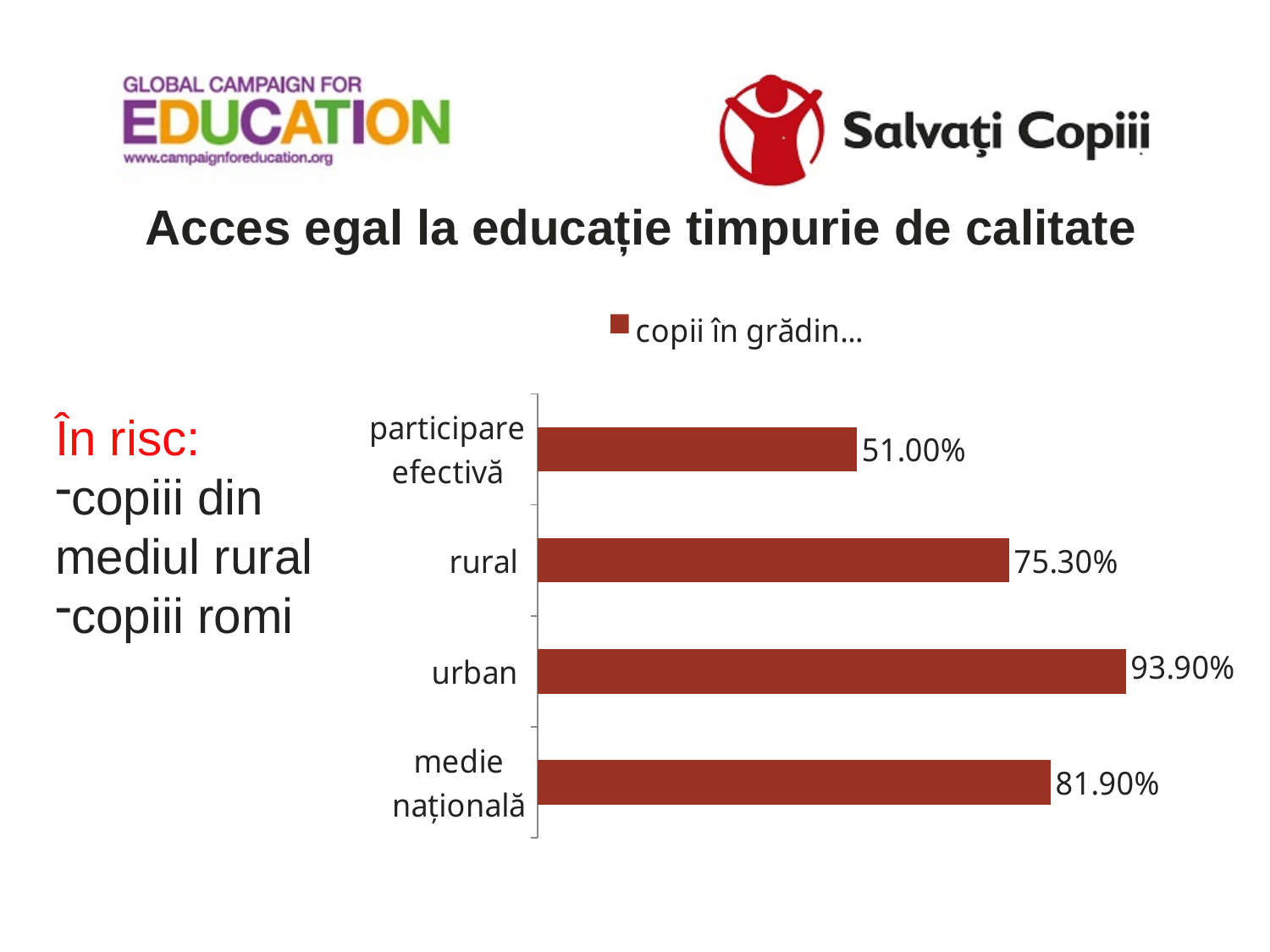
Which is larger, the value for "rural" or the value for "medie națională"? medie națională What is the value for "medie națională"? 81.90% How many categories are shown in the chart? 4 Which category has the highest value? urban How many series does the legend list? 1 What kind of chart is shown on the slide? bar chart What is the value for "participare efectivă"? 51.00% What is the difference between the values for "medie națională" and "participare efectivă"? 30.90% What is the difference between the values for "urban" and "rural"? 18.60% What is the value for "rural"? 75.30% Which category has the lowest value? participare efectivă What is the value for "urban"? 93.90%